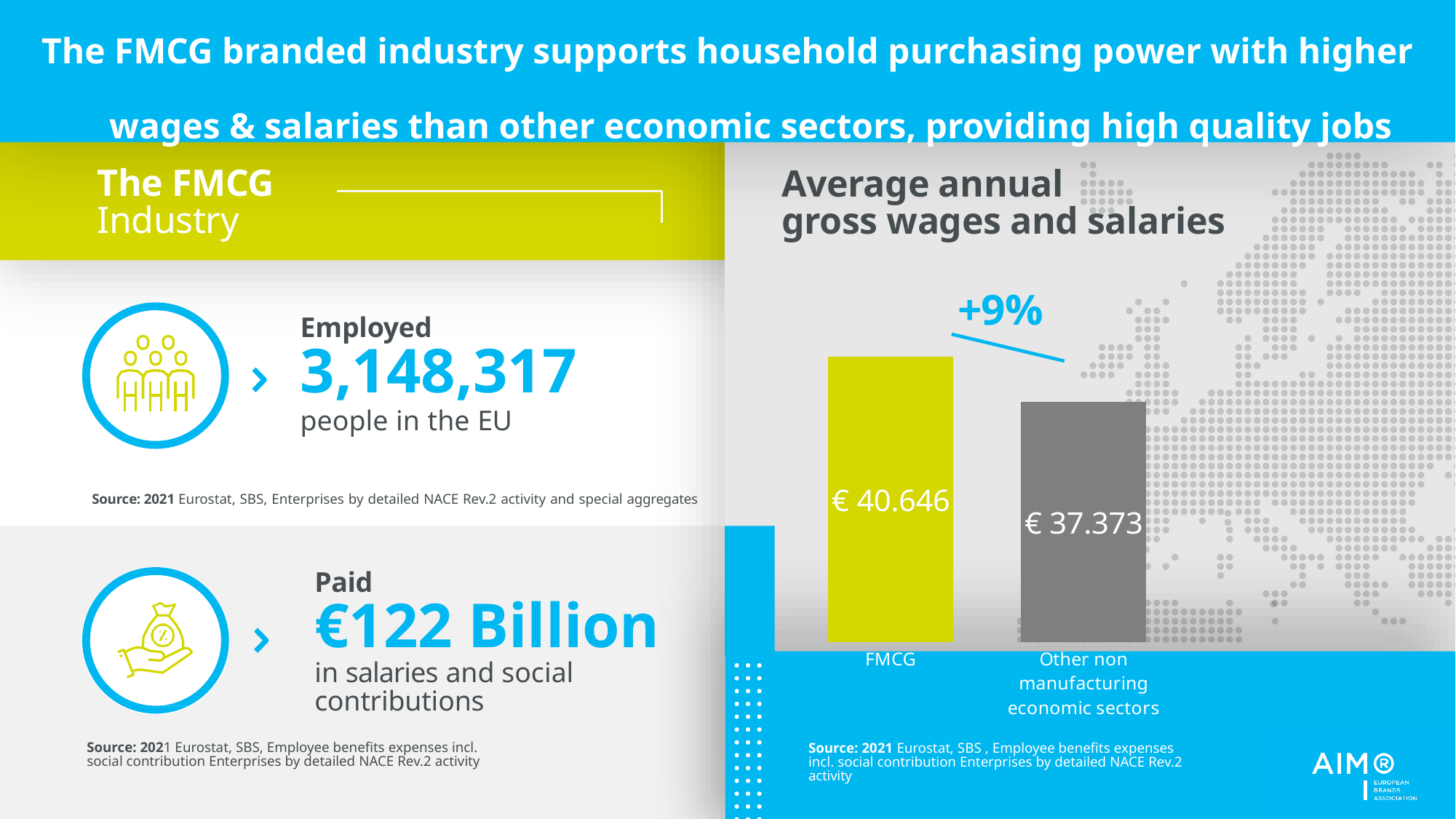
What percentage difference is annotated above the bars? +9% Is the value for FMCG larger or smaller than the value for Other non manufacturing economic sectors? larger What is the average annual gross wage and salary shown for FMCG? € 40.646 What is the title of the chart? Average annual gross wages and salaries Which category has the lower average annual gross wages and salaries? Other non manufacturing economic sectors What kind of chart is used to show average annual gross wages and salaries? bar chart How many bars are plotted in the chart? 2 What is the difference between the FMCG value and the Other non manufacturing economic sectors value? € 3.273 Which category has the higher average annual gross wages and salaries? FMCG What is the average annual gross wage and salary shown for Other non manufacturing economic sectors? € 37.373